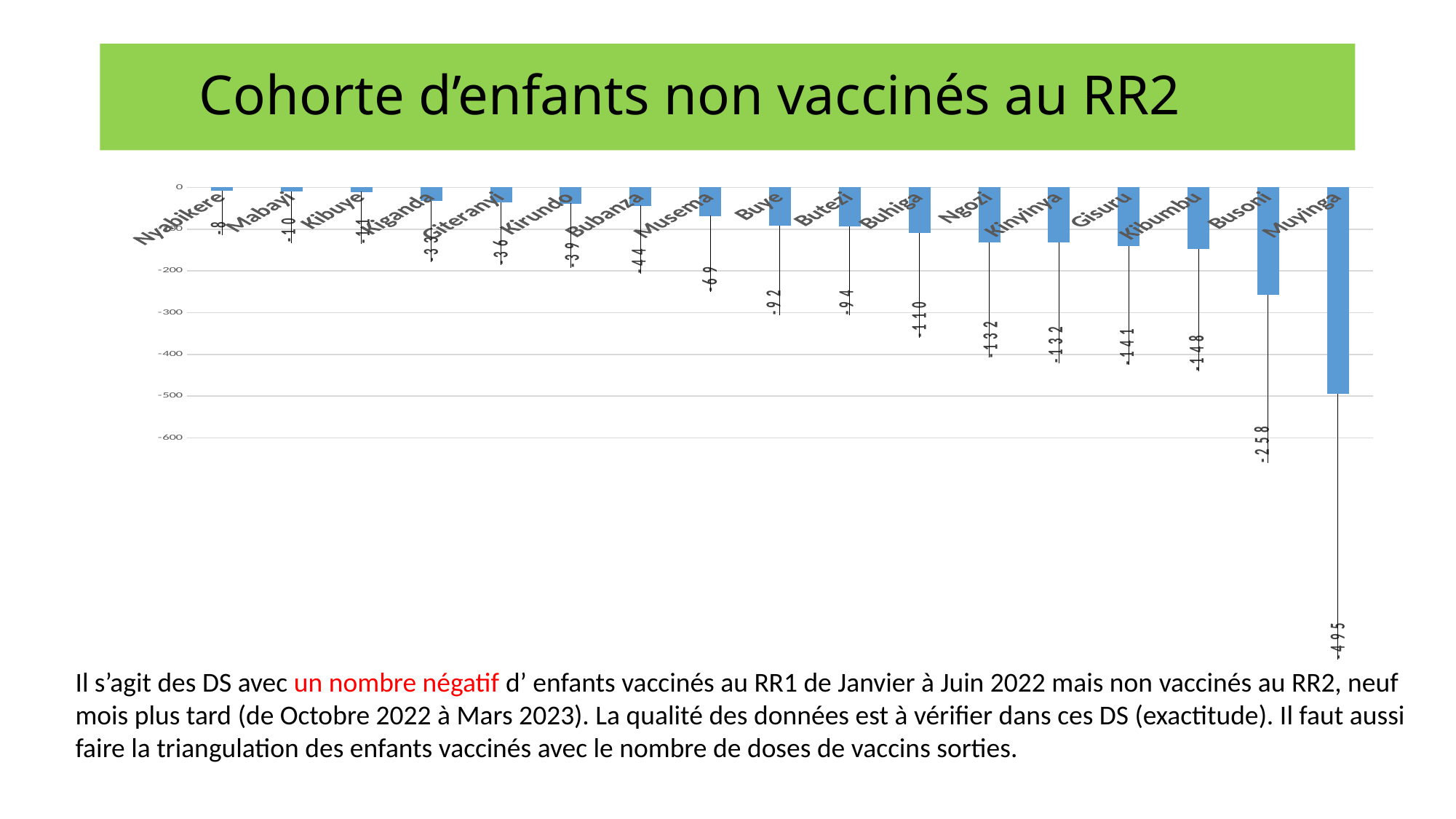
Which category has the lowest (most negative) value? Muyinga What is the title of the chart? Cohorte d’enfants non vaccinés au RR2 What is the difference between the values for Muyinga and Busoni? 237 What is the value for Musema? -69 Which has the more negative value, Gisuru or Kibumbu? Kibumbu Do the values rise or fall moving from left to right along the x axis? fall What is the value for Muyinga? -495 What is the value for Buhiga? -110 What is the value for Busoni? -258 Which category has the highest value (closest to zero)? Nyabikere What kind of chart is shown on the slide? bar chart How many categories are plotted on the chart? 17